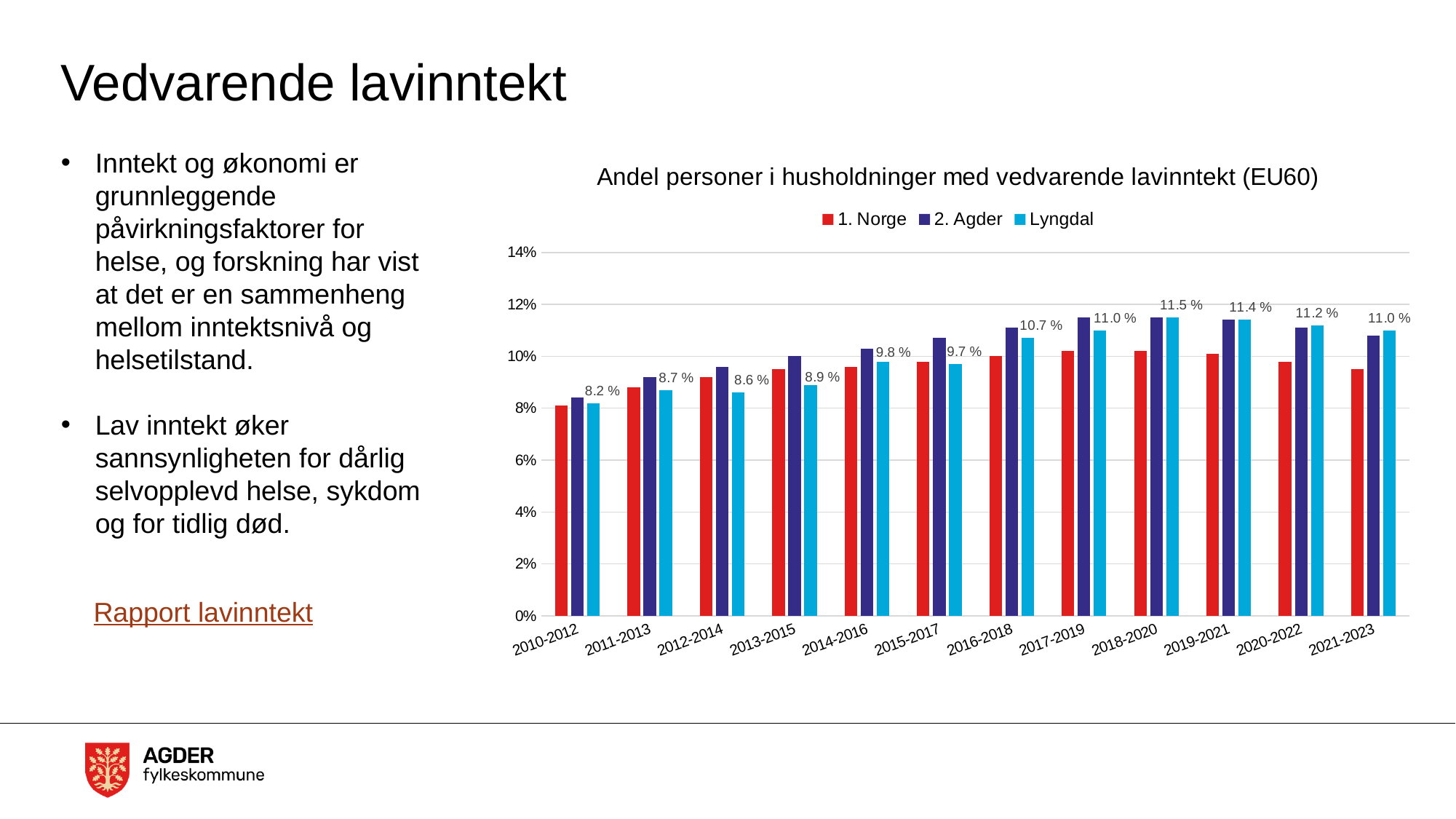
What is the difference between the Lyngdal values for 2018-2020 and 2010-2012? 3.3 percentage points What is the value for Lyngdal in 2018-2020? 11.5 % What is the value for Lyngdal in 2010-2012? 8.2 % In which period is the Lyngdal value highest? 2018-2020 In which period is the Lyngdal value lowest? 2010-2012 Which is larger for Lyngdal: the value for 2016-2018 or the value for 2013-2015? 2016-2018 Is the value for 2. Agder in 2018-2020 greater or less than 10%? greater Is the value for 1. Norge in 2010-2012 greater or less than 10%? less How many series does the legend list? 3 What is the value for Lyngdal in 2016-2018? 10.7 % What kind of chart is shown on the slide? Bar chart How many periods are shown on the x axis? 12